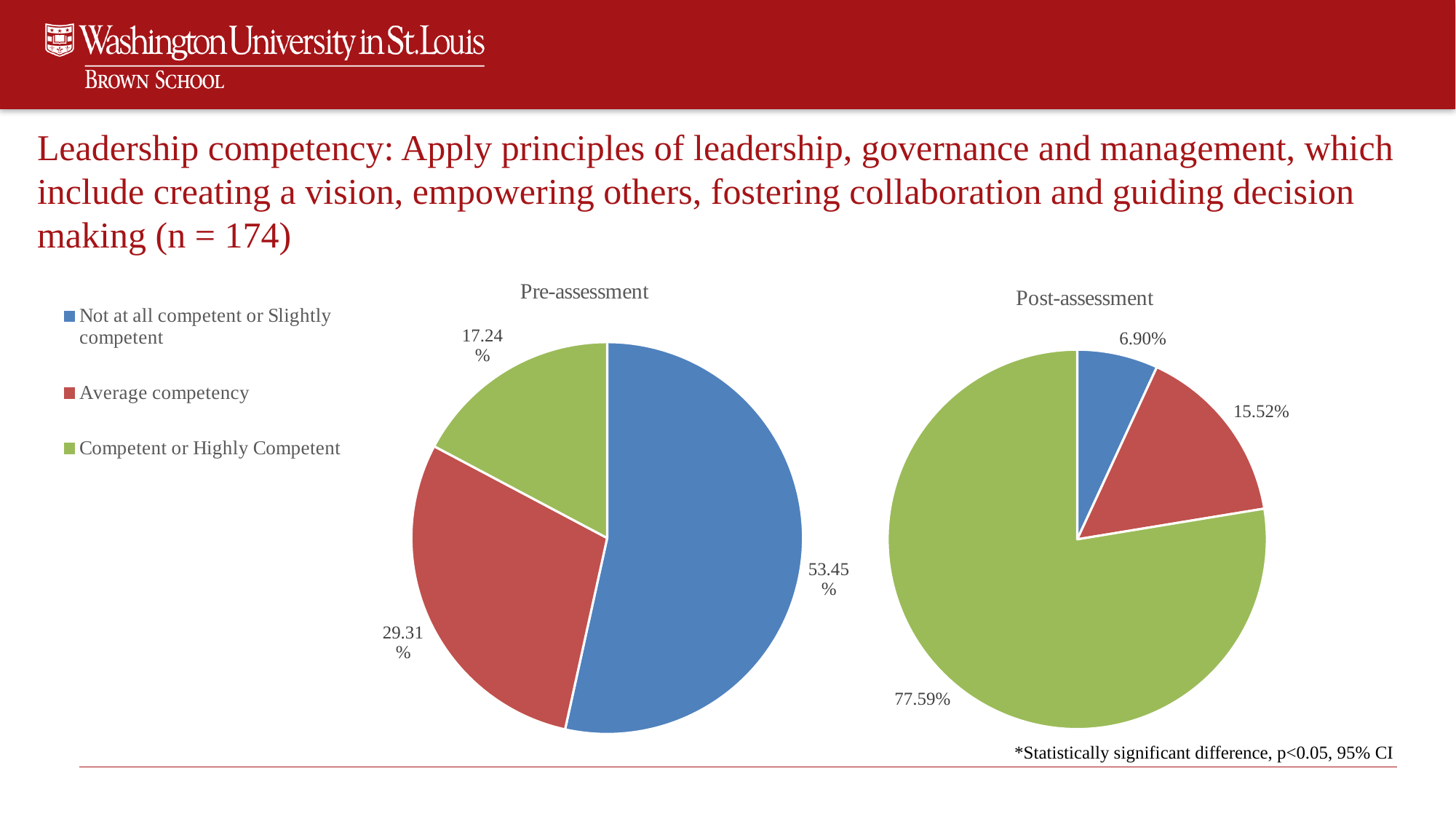
In the Pre-assessment chart, which category has the largest slice? Not at all competent or Slightly competent In the Post-assessment chart, which category has the smallest slice? Not at all competent or Slightly competent How many categories does the legend list? 3 In the Pre-assessment chart, what is the value for Competent or Highly Competent? 17.24% In the Post-assessment chart, what share of respondents were Competent or Highly Competent? 77.59% How many slices does the Post-assessment pie chart have? 3 In the Post-assessment chart, what is the value for Average competency? 15.52% What type of chart is used for the Pre-assessment data? Pie chart In the Pre-assessment chart, what is the difference between the Average competency slice and the Competent or Highly Competent slice? 12.07% Which colour represents Average competency in the charts? Red Which is larger in the Post-assessment chart: Average competency or Not at all competent or Slightly competent? Average competency In the Pre-assessment chart, what share of respondents were Not at all competent or Slightly competent? 53.45%